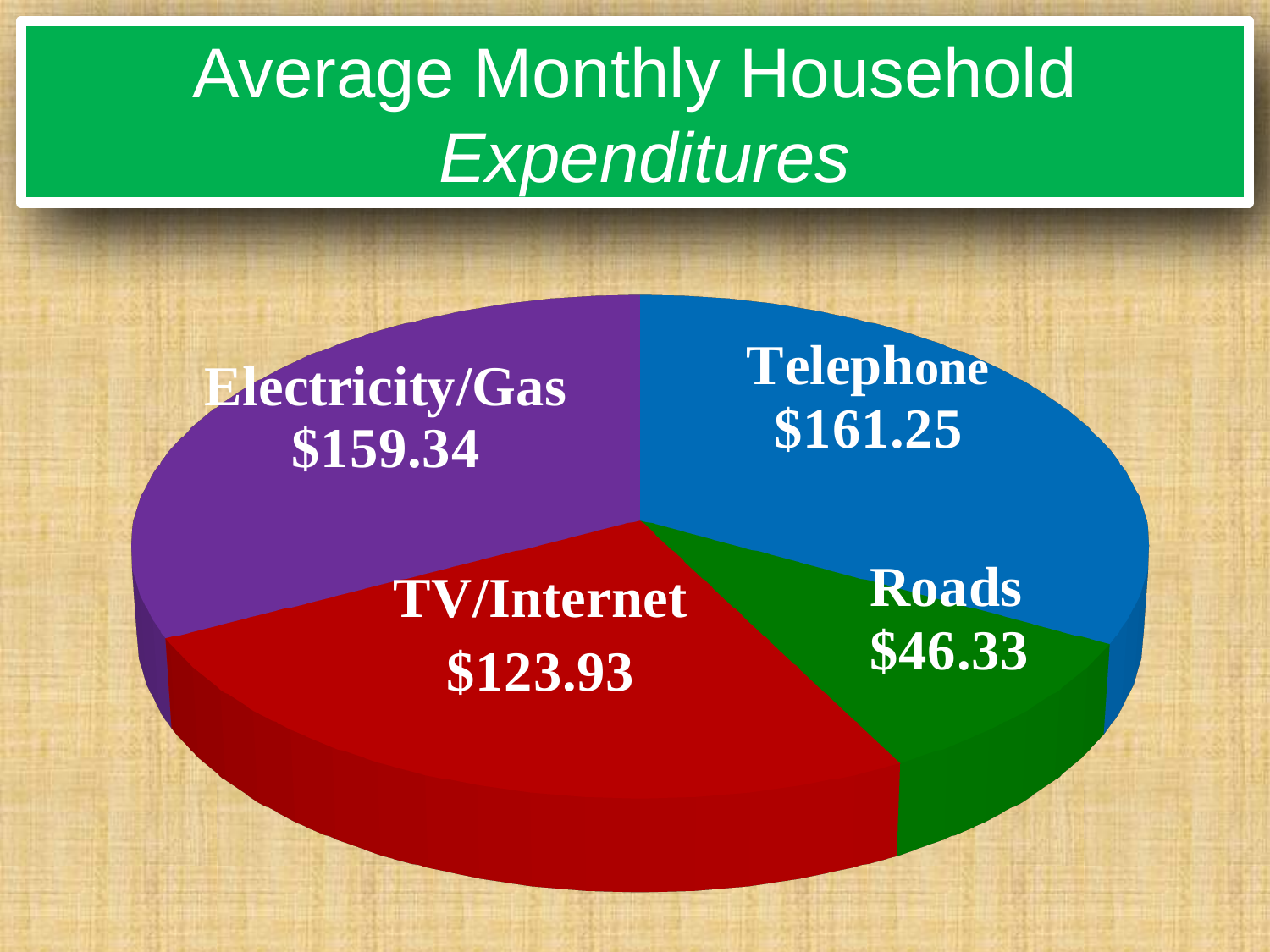
What kind of chart is shown on the slide? Pie chart Which category has the smallest expenditure? Roads How much more is spent on Electricity/Gas than on TV/Internet? $35.41 What is the value shown for TV/Internet? $123.93 What colour is the Roads slice? Green Which is larger, the expenditure on TV/Internet or on Roads? TV/Internet What is the value shown for Roads? $46.33 Which category has the largest expenditure? Telephone What is the average monthly household expenditure on Telephone? $161.25 What is the difference between the Telephone and Roads expenditures? $114.92 How many categories are shown in the pie chart? 4 What is the value shown for Electricity/Gas? $159.34